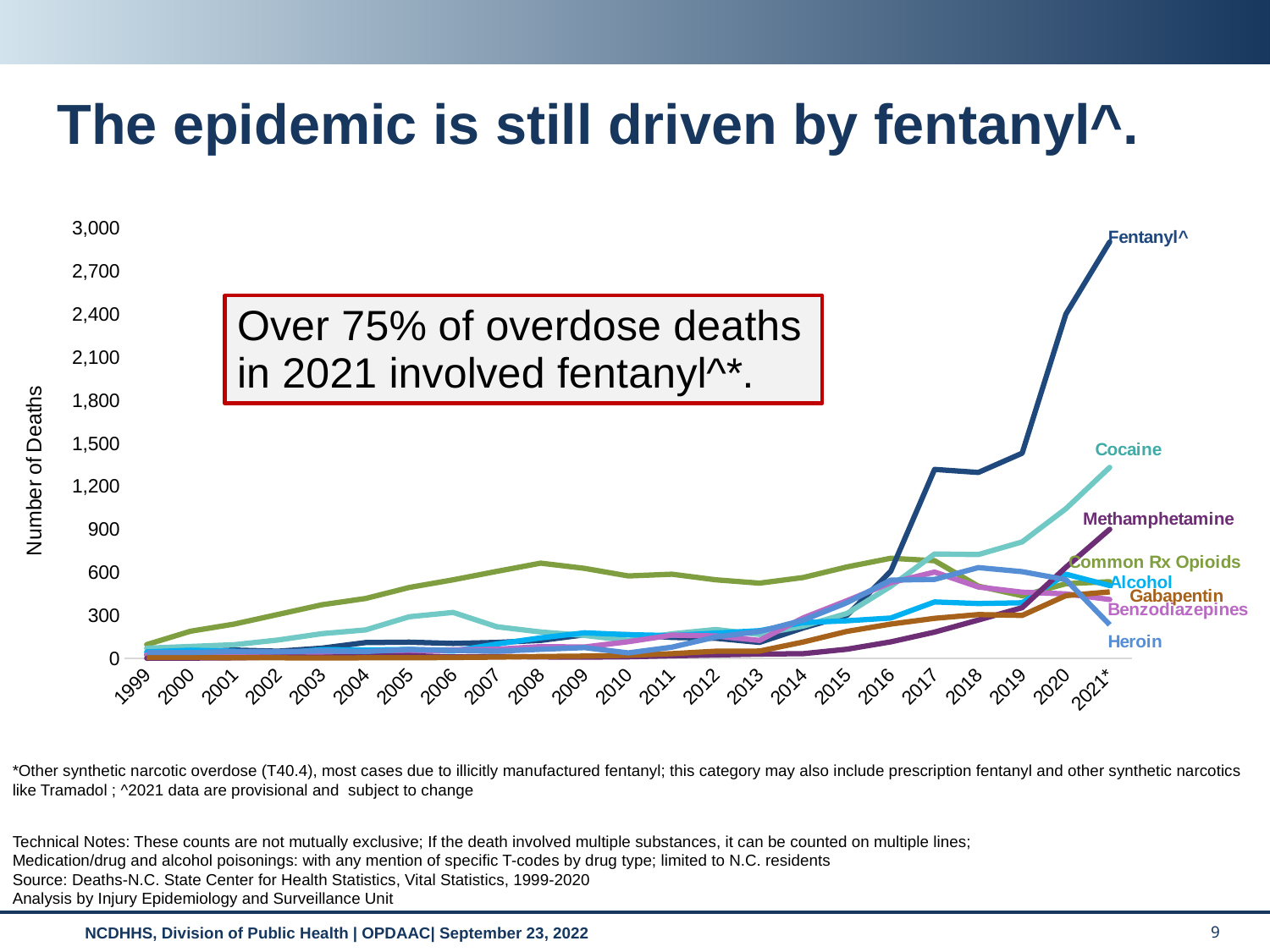
Which substance has the highest number of deaths in 2021*? Fentanyl^ Is the value for Fentanyl^ in 2021* greater or less than 2,700? greater Which labelled substance has the lowest number of deaths in 2021*? Heroin Is the value for Cocaine in 2021* greater or less than 1,200? greater Is the value for Heroin in 2021* greater or less than 300? less Does the Fentanyl^ line rise or fall between 2015 and 2021*? rise How many years are shown along the x axis of the chart? 23 What kind of chart is shown on the slide? line chart How many substance series are labelled on the chart? 8 What is the label on the y axis of the chart? Number of Deaths In 2021*, which has more deaths, Cocaine or Heroin? Cocaine